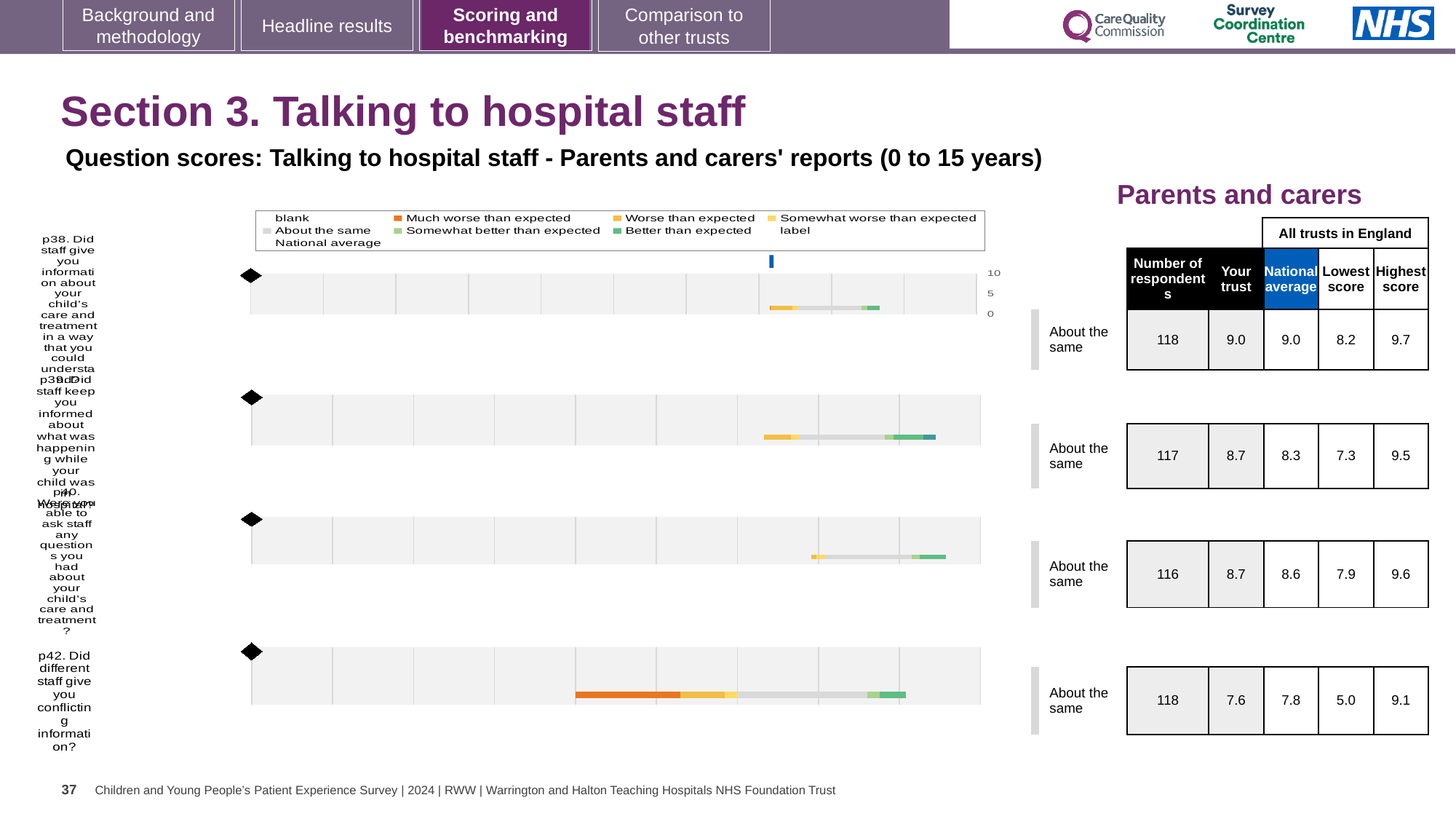
For p39, which is larger: the 'Your trust' score or the national average? Your trust In the table next to the charts, what is the number of respondents for p38 (Did staff give you information about your child's care and treatment in a way that you could understand?)? 118 How many survey questions (p38, p39, p40, p42) are plotted on the slide? 4 For p42, what is the difference between the highest score (9.1) and the lowest score (5.0) in the table? 4.1 Which question has the lowest 'Your trust' score in the table? p42 Which question has the highest 'Your trust' score in the table? p38 What colour does the legend use for 'Much worse than expected'? orange In the table next to the charts, what is the national average score for p39 (Did staff keep you informed about what was happening while your child was in hospital?)? 8.3 In the table next to the charts, what is the 'Your trust' score for p42 (Did different staff give you conflicting information?)? 7.6 What kind of chart is used to show the question scores on this slide? bar chart In the table next to the charts, what is the lowest score across all trusts in England for p42? 5.0 In the table next to the charts, what is the highest score across all trusts in England for p38? 9.7